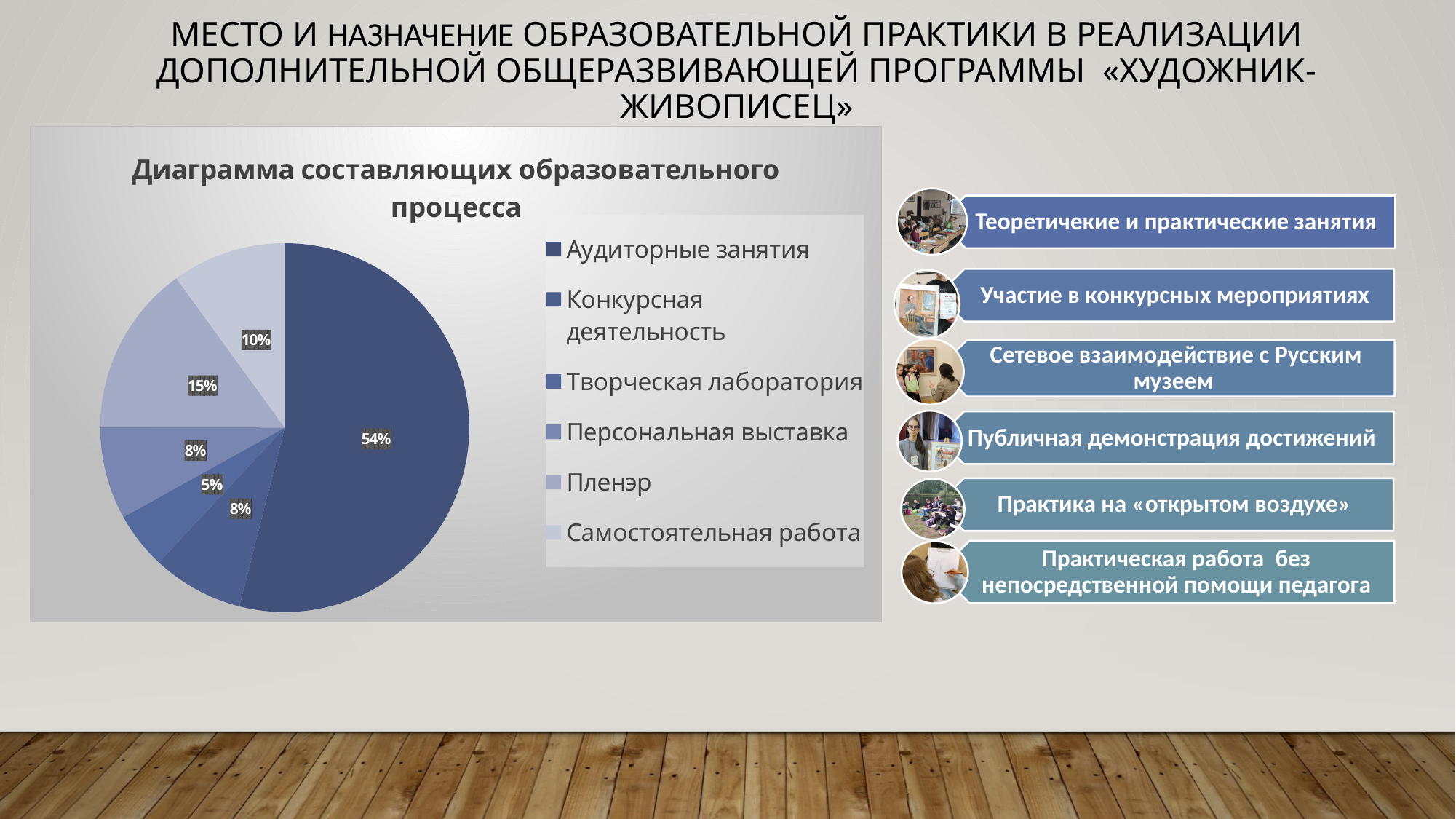
What is the value shown for Конкурсная деятельность? 8% Which category has the largest slice of the pie? Аудиторные занятия What share of the pie does Аудиторные занятия take? 54% What kind of chart is shown on the slide? pie chart What is the difference between the shares of Аудиторные занятия and Пленэр? 39% How many categories does the legend of the pie chart list? 6 What is the value shown for Самостоятельная работа? 10% What is the value shown for Творческая лаборатория? 5% What is the title of the chart? Диаграмма составляющих образовательного процесса What is the value shown for Пленэр? 15% Which is larger, the share of Пленэр or the share of Самостоятельная работа? Пленэр Which category has the smallest slice of the pie? Творческая лаборатория